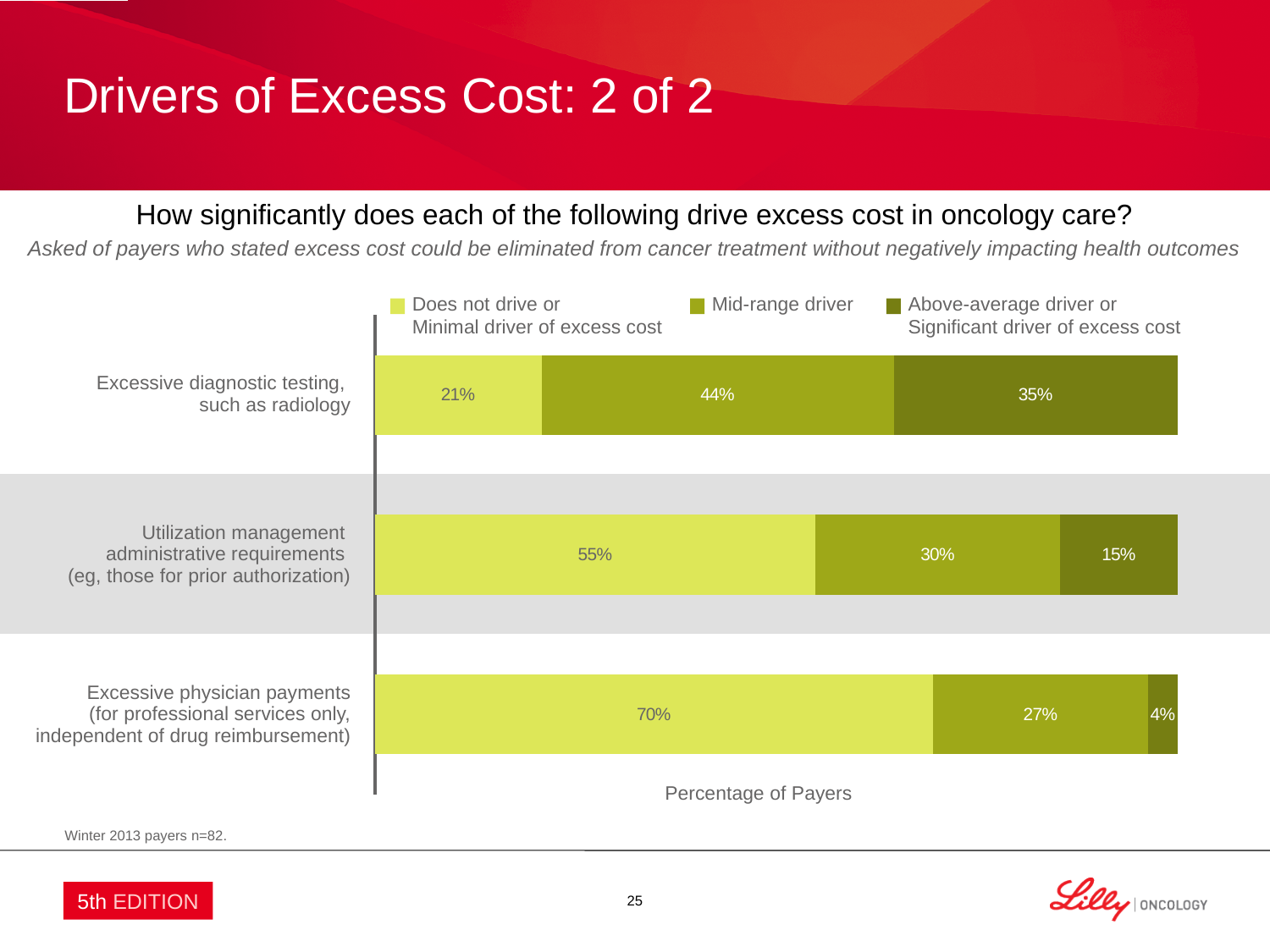
Which is larger: the mid-range driver percentage for excessive diagnostic testing or for excessive physician payments? Excessive diagnostic testing What kind of chart is shown on the slide? Stacked bar chart What percentage of payers said excessive physician payments does not drive or is a minimal driver of excess cost? 70% What is the difference between the 'Does not drive or Minimal driver' percentages for utilization management administrative requirements and excessive diagnostic testing? 34 percentage points Which category has the highest percentage in the 'Does not drive or Minimal driver of excess cost' series? Excessive physician payments What is the x-axis label of the chart? Percentage of Payers How many categories (drivers) are shown in the chart? 3 Which category has the lowest percentage in the 'Above-average driver or Significant driver of excess cost' series? Excessive physician payments What is the total of the three segments for the utilization management administrative requirements bar? 100% What percentage of payers rated utilization management administrative requirements as a mid-range driver? 30% What percentage of payers rated excessive diagnostic testing as an above-average or significant driver of excess cost? 35% How many series does the legend list? 3